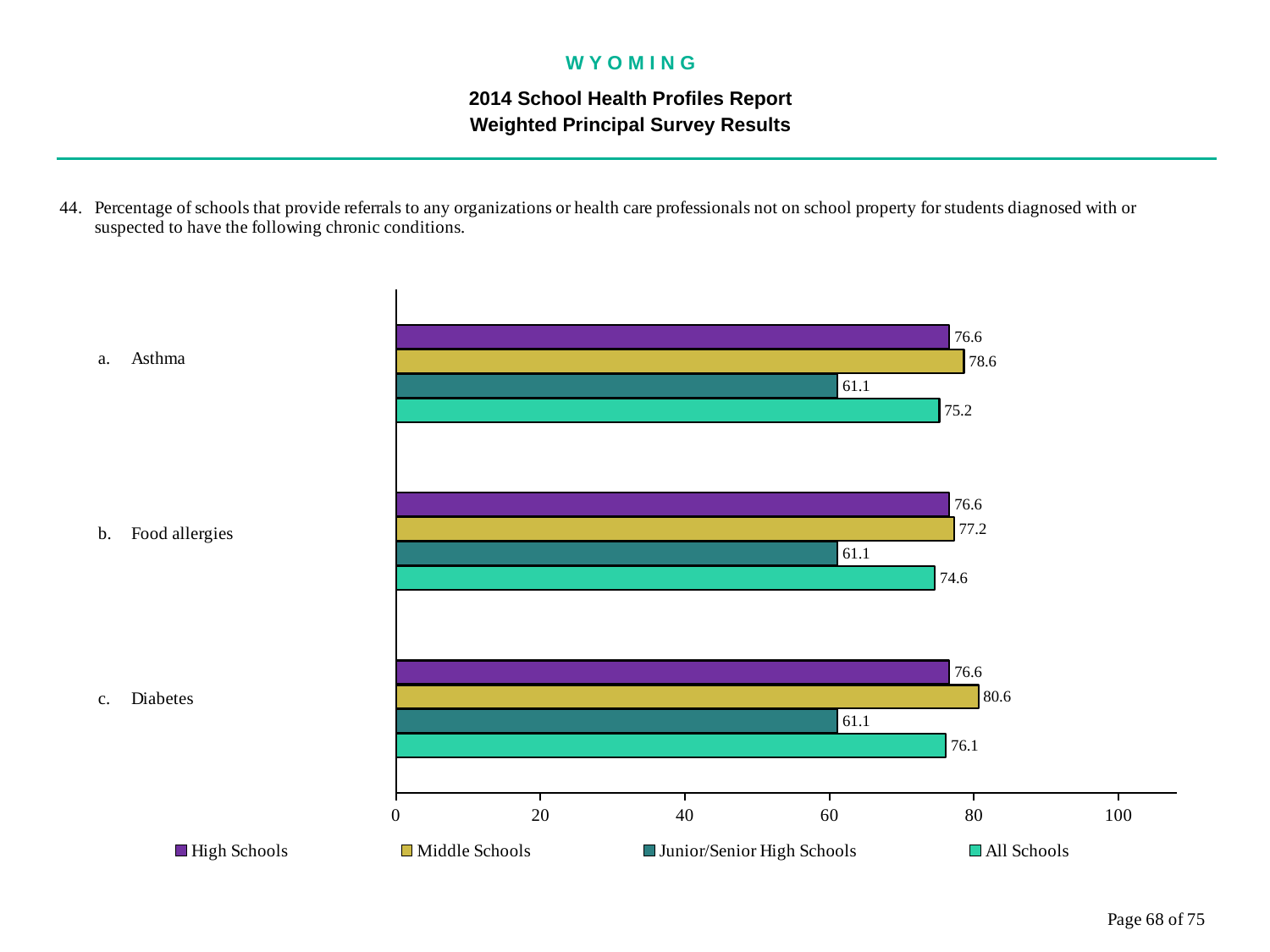
How many series does the legend list? 4 Which condition has the highest Middle Schools value? Diabetes What is the value for Middle Schools for Asthma? 78.6 How many chronic conditions are shown on the chart? 3 Which series has the lowest value for Asthma? Junior/Senior High Schools Is the value for Junior/Senior High Schools for Diabetes greater or less than 80? less What is the difference between the All Schools values for Asthma and Food allergies? 0.6 Which is larger for Food allergies: the Middle Schools value or the All Schools value? Middle Schools What is the value for All Schools for Diabetes? 76.1 What is the value for Junior/Senior High Schools for Food allergies? 61.1 What kind of chart is shown? bar chart What is the difference between the Middle Schools and High Schools values for Diabetes? 4.0